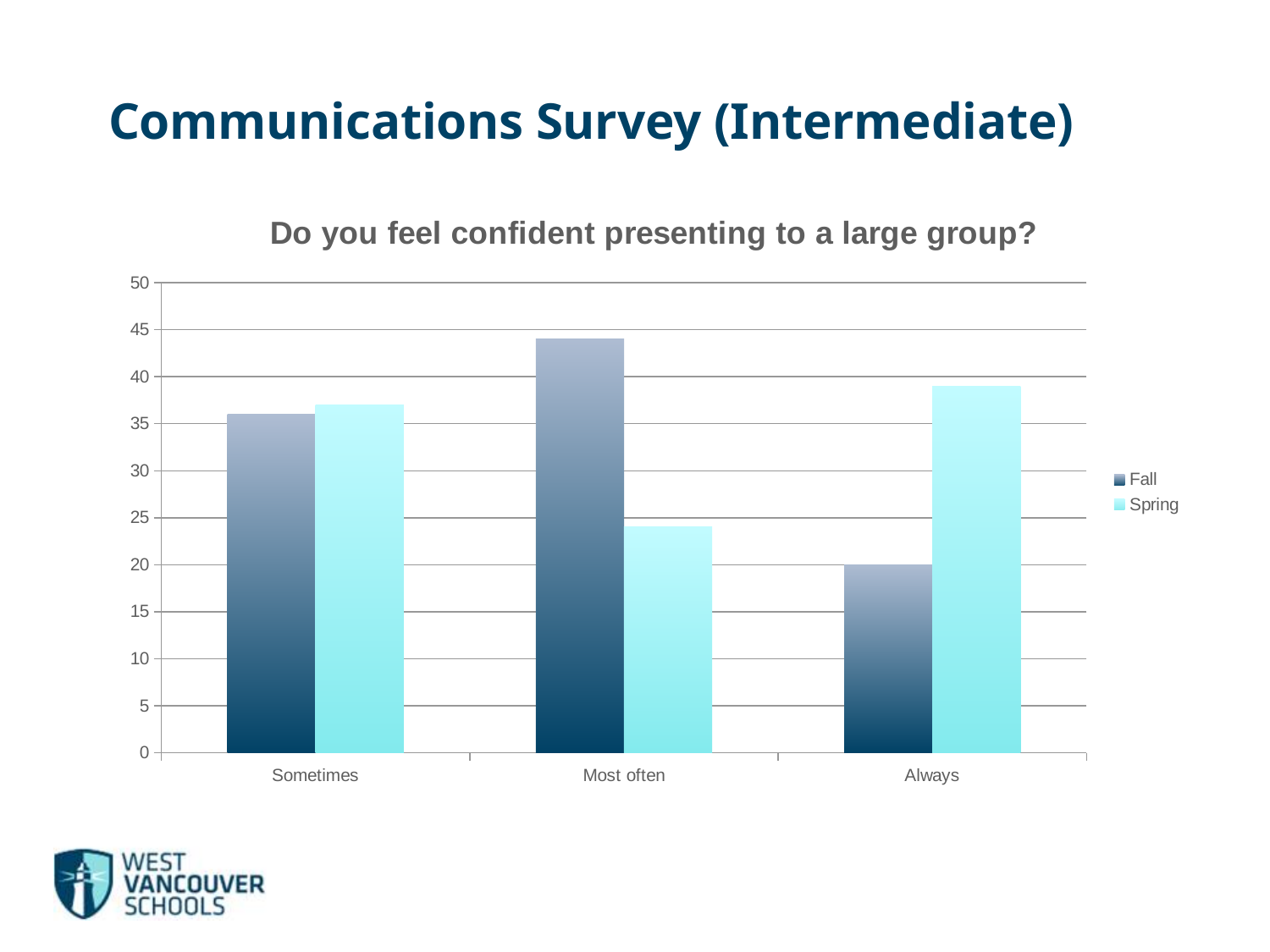
How many series does the legend list? 2 Which category has the highest Spring value? Always What type of chart is shown on the slide? bar chart Which category has the highest Fall value? Most often How many categories are shown on the x axis? 3 What is the title of the chart? Do you feel confident presenting to a large group? Which category has the lowest Spring value? Most often Is the Fall value for Most often greater or less than 40? greater For Always, is the Fall value or the Spring value larger? Spring Which category has the lowest Fall value? Always Is the Spring value for Most often greater or less than 30? less For Most often, is the Fall value or the Spring value larger? Fall